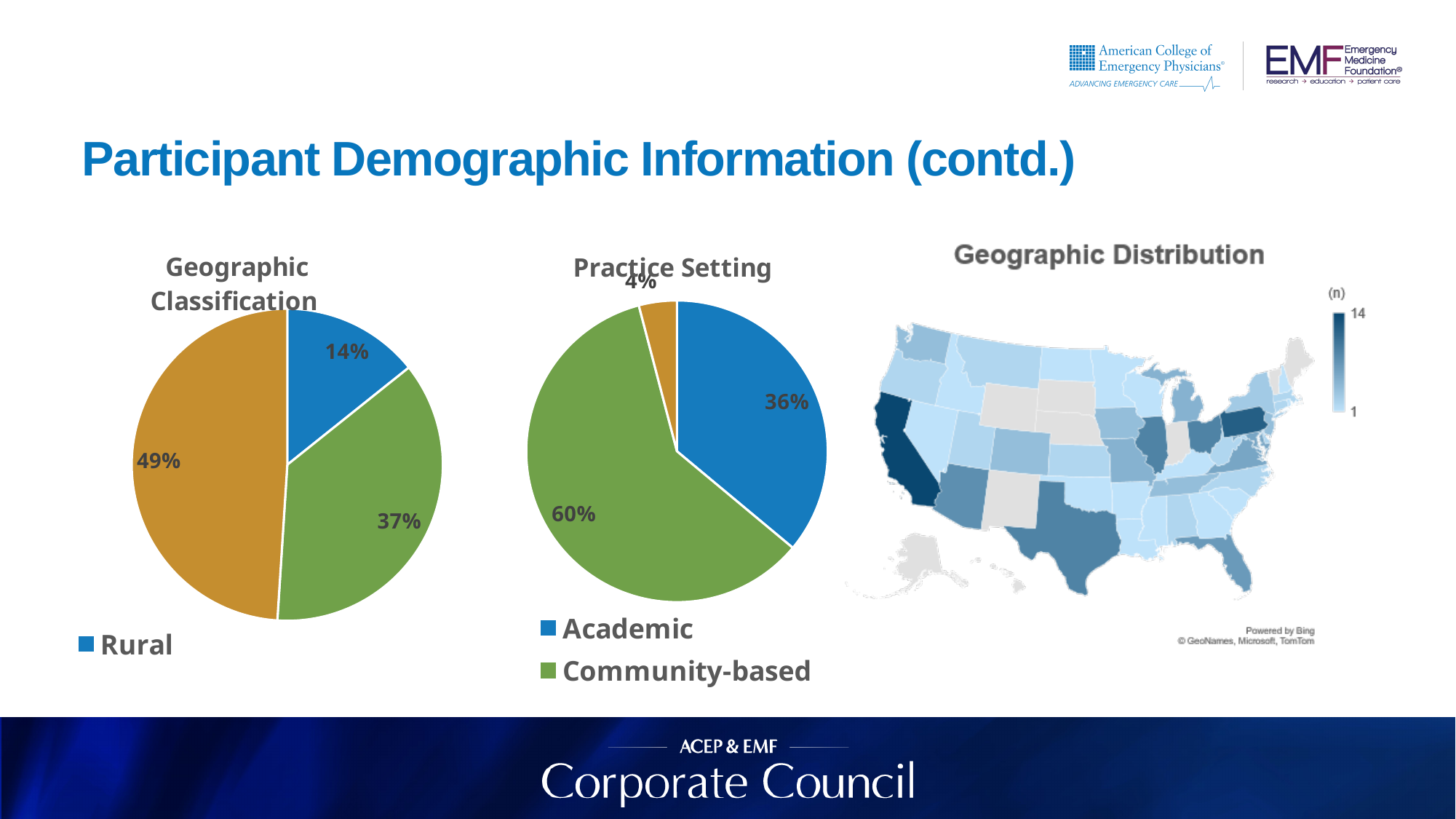
In the Practice Setting pie chart, how many entries does the legend list? 2 What is the title of the map chart on the right of the slide? Geographic Distribution In the Geographic Classification pie chart, what percentage is shown for Rural? 14% In the Practice Setting pie chart, what percentage is shown for Community-based? 60% In the Geographic Classification pie chart, what colour is the Rural slice? Blue In the Practice Setting pie chart, what percentage is shown for Academic? 36% In the Practice Setting pie chart, what is the smallest percentage shown on any slice? 4% In the Geographic Classification pie chart, how many slices does the pie have? 3 In the Practice Setting pie chart, which is larger, Academic or Community-based? Community-based In the Practice Setting pie chart, what is the difference in percentage points between Community-based and Academic? 24 percentage points What kind of chart is the Practice Setting chart? Pie chart In the Geographic Classification pie chart, what is the largest percentage shown on any slice? 49%